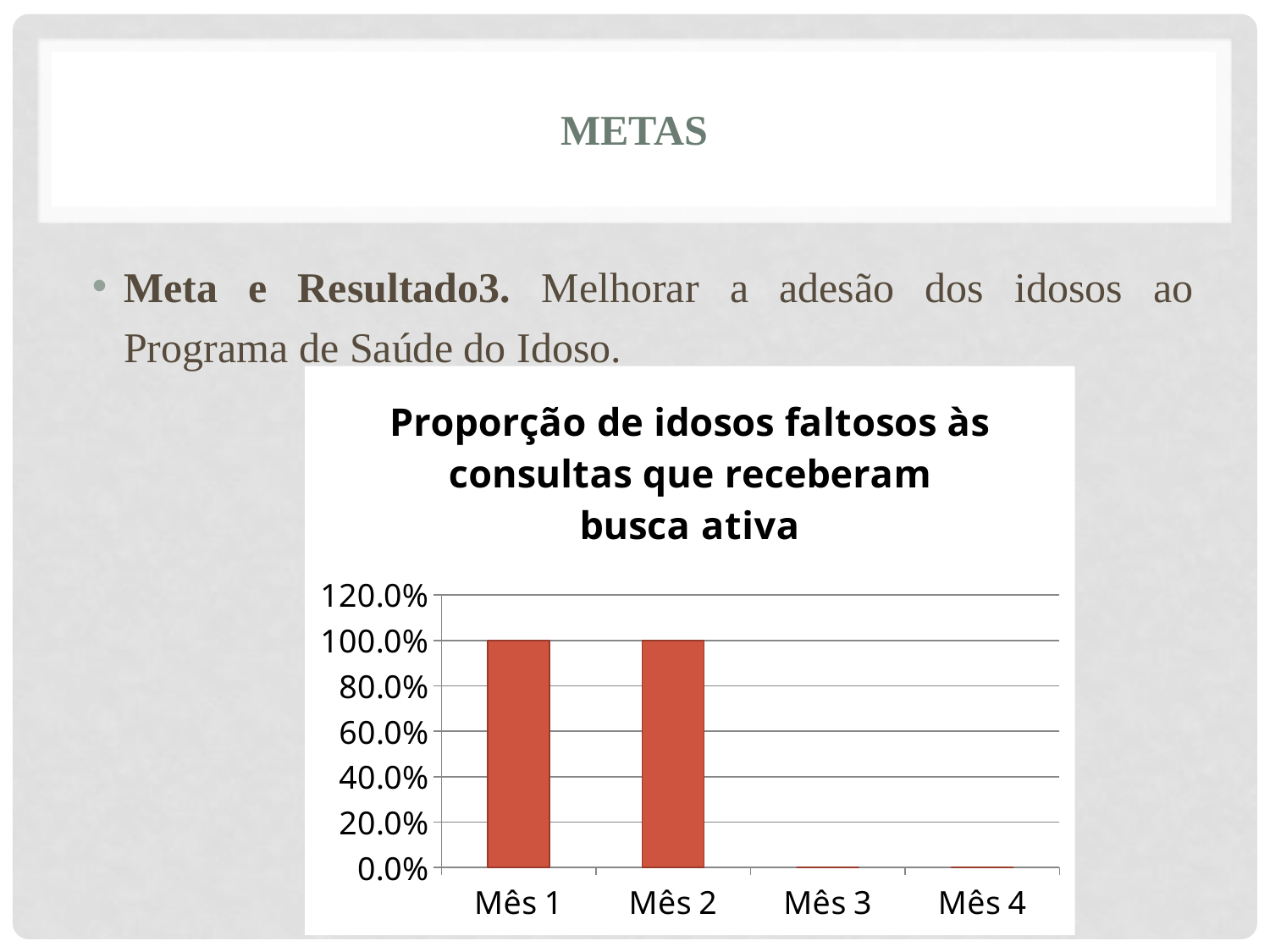
What is the value for Mês 2? 100.0% How many months (categories) are shown on the x axis of the chart? 4 Is the value for Mês 4 greater or less than 20.0%? less Which is larger, the value for Mês 2 or the value for Mês 3? Mês 2 What type of chart is shown on the slide? Bar chart Is the value for Mês 3 greater or less than 20.0%? less Which is larger, the value for Mês 4 or the value for Mês 1? Mês 1 What is the title of the chart? Proporção de idosos faltosos às consultas que receberam busca ativa Do the values rise or fall from Mês 2 to Mês 3? fall What is the value for Mês 1? 100.0% Is the value for Mês 1 greater or less than 80.0%? greater What is the highest value shown on the vertical axis of the chart? 120.0%